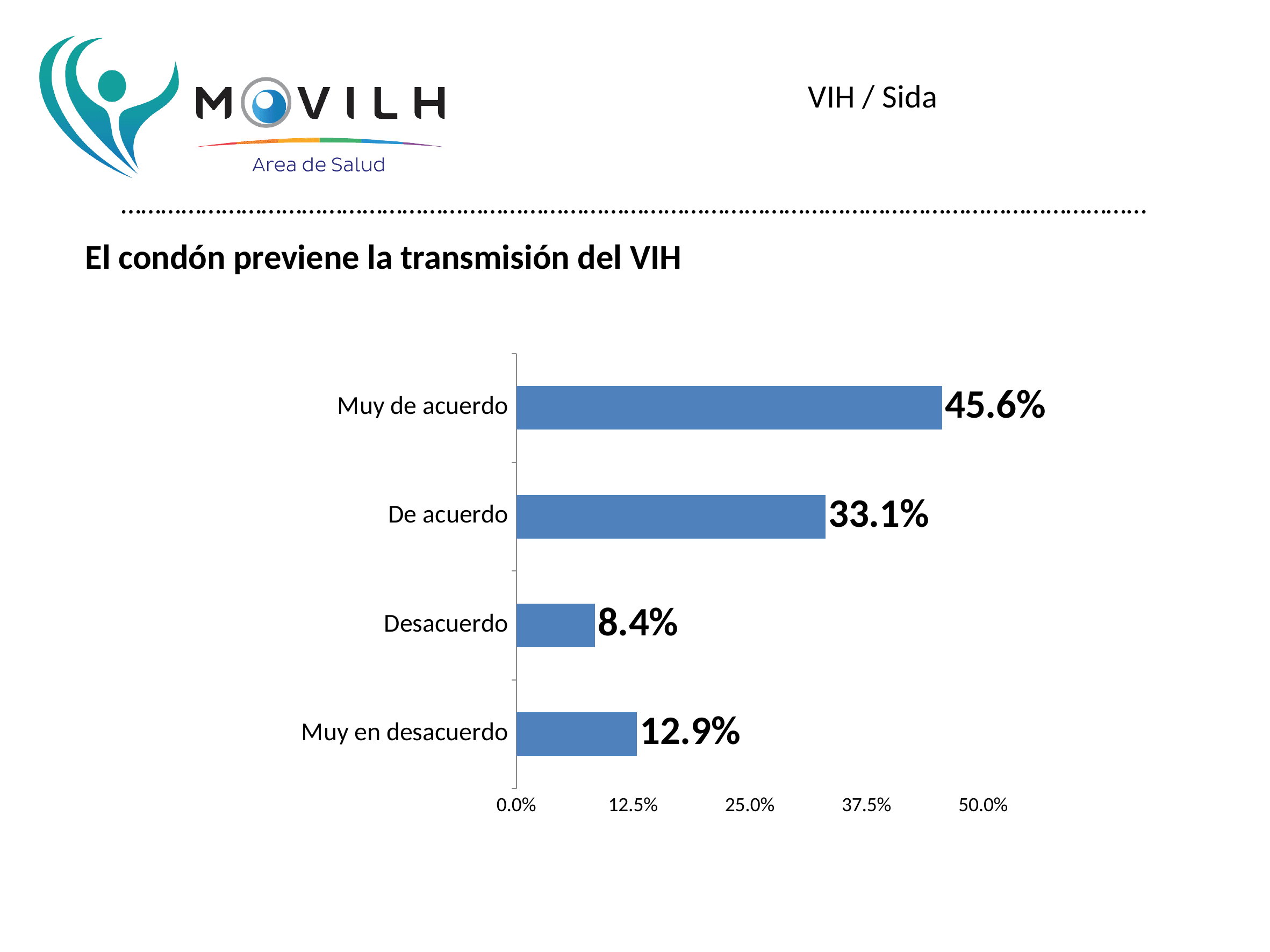
What is the difference between the values for Muy en desacuerdo and Desacuerdo? 4.5% What is the value for Muy en desacuerdo? 12.9% What is the value for Muy de acuerdo? 45.6% How many categories are shown in the chart? 4 What is the value for Desacuerdo? 8.4% What is the difference between the values for Muy de acuerdo and De acuerdo? 12.5% What is the value for De acuerdo? 33.1% What kind of chart is shown on the slide? Bar chart Which category has the highest value? Muy de acuerdo Is the value for De acuerdo greater or less than 25.0%? greater Which category has the lowest value? Desacuerdo Which is larger, the value for Muy en desacuerdo or the value for Desacuerdo? Muy en desacuerdo